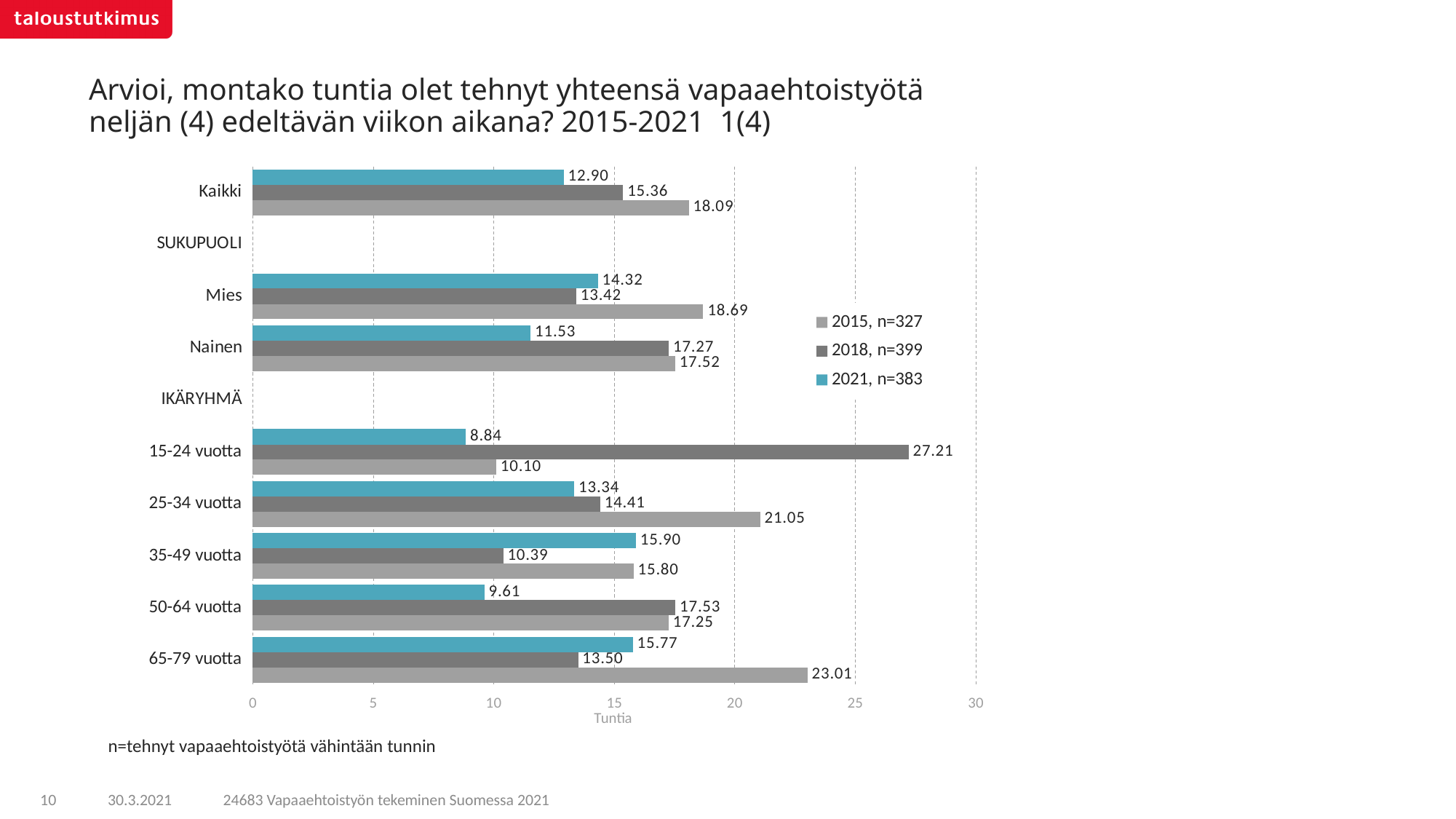
What kind of chart is shown on the slide? Bar chart What is the difference between the 2018 and 2015 values for 15-24 vuotta? 17.11 Which category has the highest 2018 value? 15-24 vuotta What is the 2021 value for Kaikki? 12.90 What is the 2018 value for Nainen? 17.27 Does the value for Kaikki rise or fall from 2015 to 2021? Falls How many series does the legend list? 3 How many categories have bars plotted in the chart? 8 What is the difference between the 2015 and 2021 values for Kaikki? 5.19 What is the 2015 value for 65-79 vuotta? 23.01 Which category has the lowest 2021 value? 15-24 vuotta Which is larger, the 2021 value for Mies or the 2021 value for Nainen? Mies